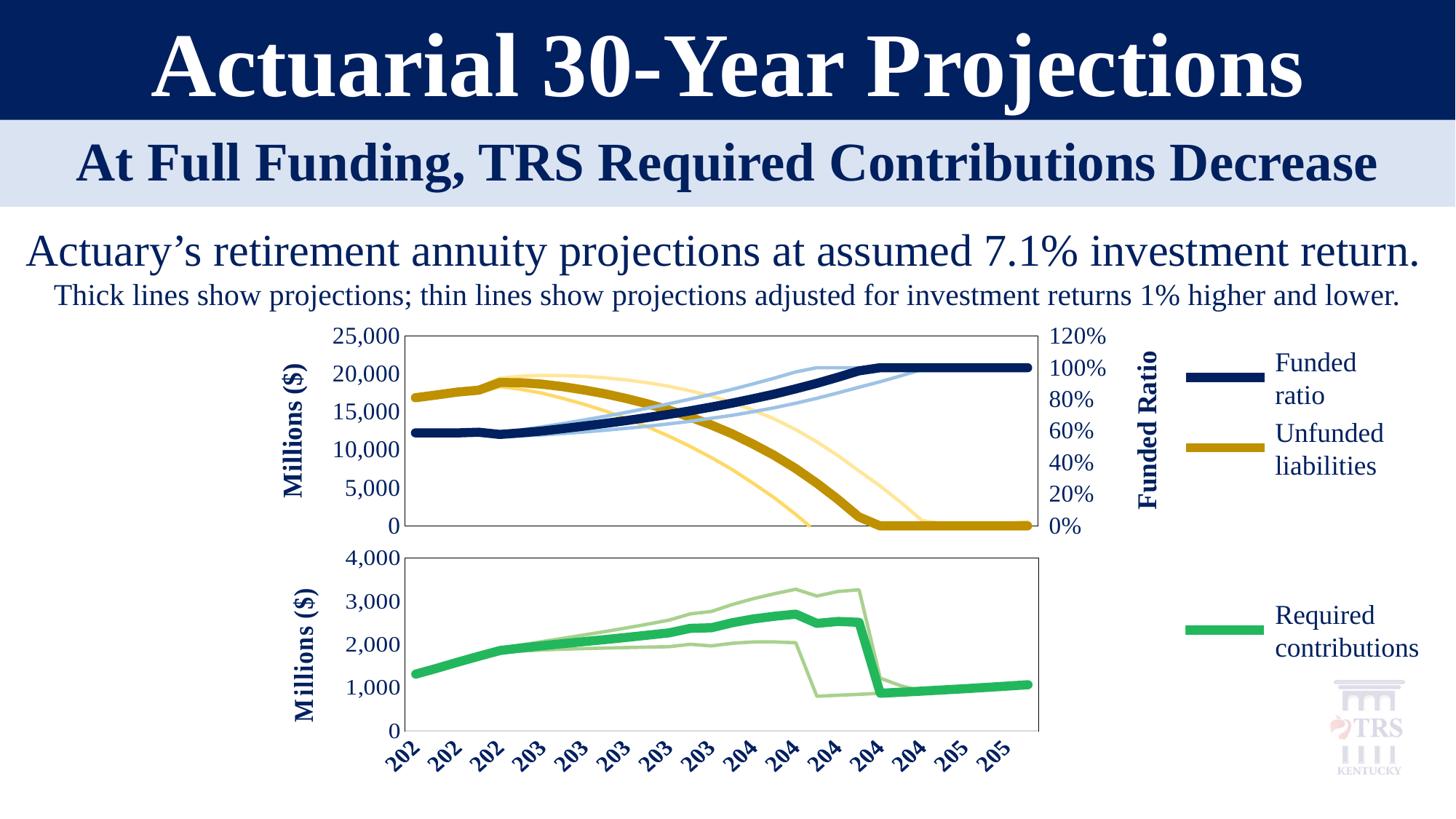
In the top chart, does the thick Funded ratio line rise or fall over time along the x axis? Rise In the bottom chart, is the peak of the thick Required contributions line greater or less than 3,000? less In the top chart, is the Unfunded liabilities value at the right end of the thick line greater or less than 5,000? less What kind of chart is the top chart on the slide? Line chart In the top chart, is the Unfunded liabilities value at the left end of the thick line greater or less than 15,000? greater In the top chart, does the thick Unfunded liabilities line rise or fall over time along the x axis? Fall How many series does the legend of the bottom chart list? 1 How many series does the legend of the top chart list? 2 What is the label of the right-hand vertical axis of the top chart? Funded Ratio What kind of chart is the bottom chart on the slide? Line chart